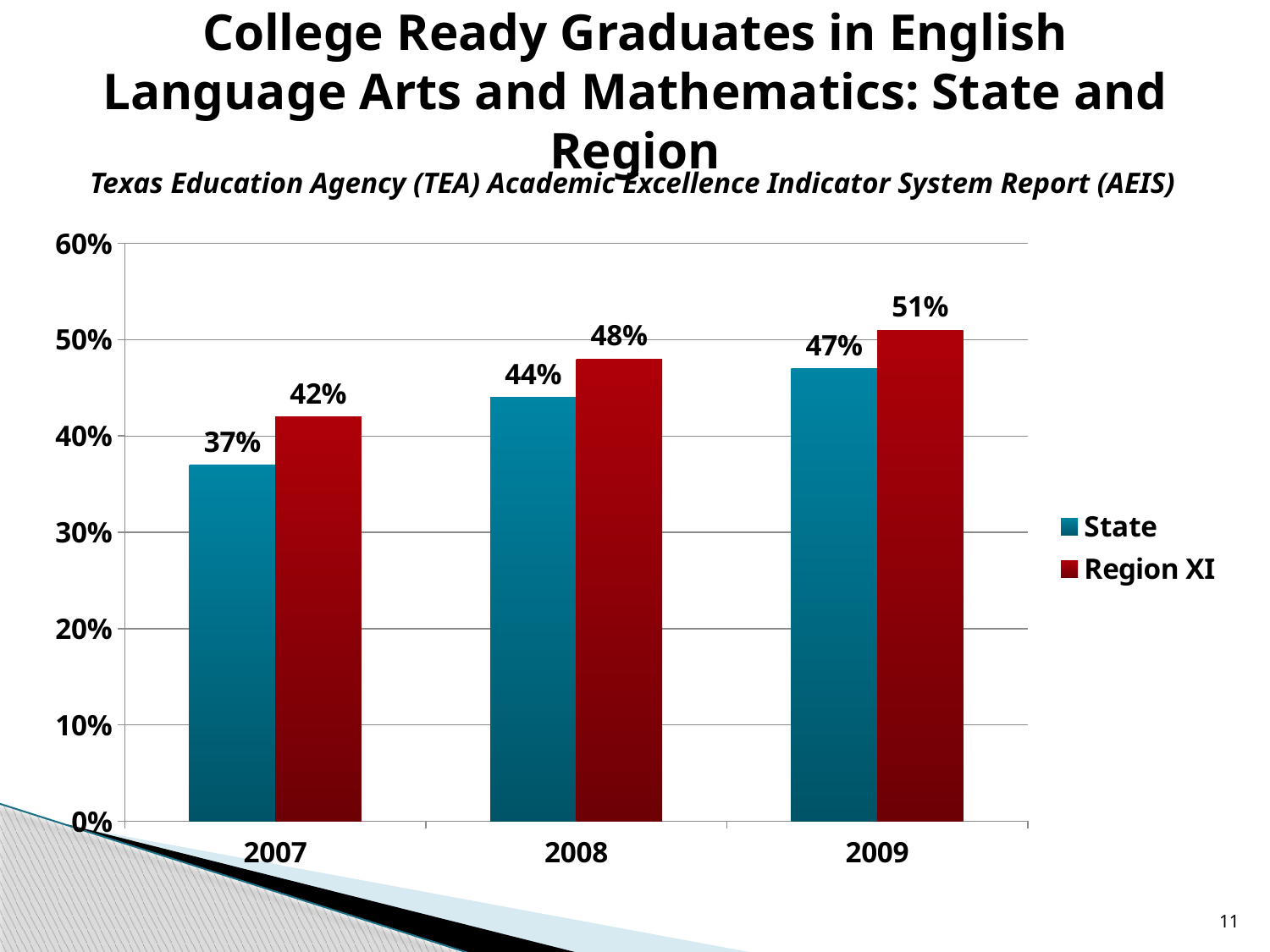
What is the difference between the State values for 2009 and 2007? 10% What is the difference between the Region XI and State values in 2008? 4% What is the State value for 2007? 37% What kind of chart is shown on the slide? Bar chart Do the Region XI values rise or fall from 2007 to 2009? Rise What is the Region XI value for 2009? 51% How many years are shown on the x axis? 3 In which year is the Region XI value lowest? 2007 Which is larger in 2009, the State value or the Region XI value? Region XI What is the Region XI value for 2008? 48% How many series does the legend list? 2 In which year is the State value highest? 2009